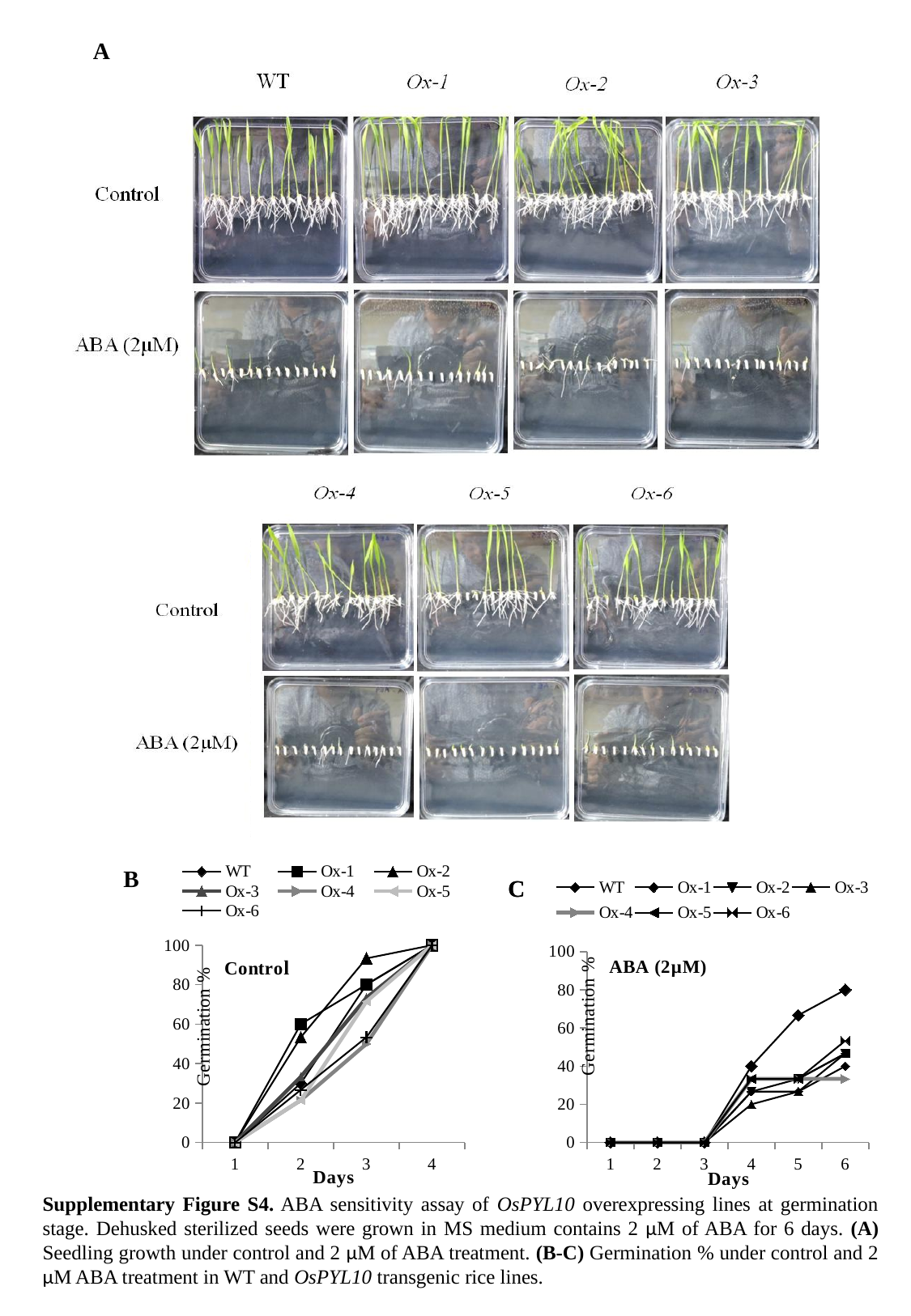
In the Control chart (B), is the value for Ox-1 at day 2 greater or less than 40? greater How many days are shown on the x axis of the ABA (2µM) chart (C)? 6 How many series does the legend of the Control chart (B) list? 7 In the Control chart (B), what is the germination % for WT at day 4? 100 In the ABA (2µM) chart (C), what is the germination % for WT at day 3? 0 What kind of chart is the Control chart (B)? line chart How many days are shown on the x axis of the Control chart (B)? 4 In the ABA (2µM) chart (C), which line has the highest germination % at day 6? WT What is the label on the y axis of the Control chart (B)? Germination % How many series does the legend of the ABA (2µM) chart (C) list? 7 In the ABA (2µM) chart (C), what is the germination % for WT at day 6? 80 In the ABA (2µM) chart (C), is the value for Ox-4 at day 6 greater or less than 40? less